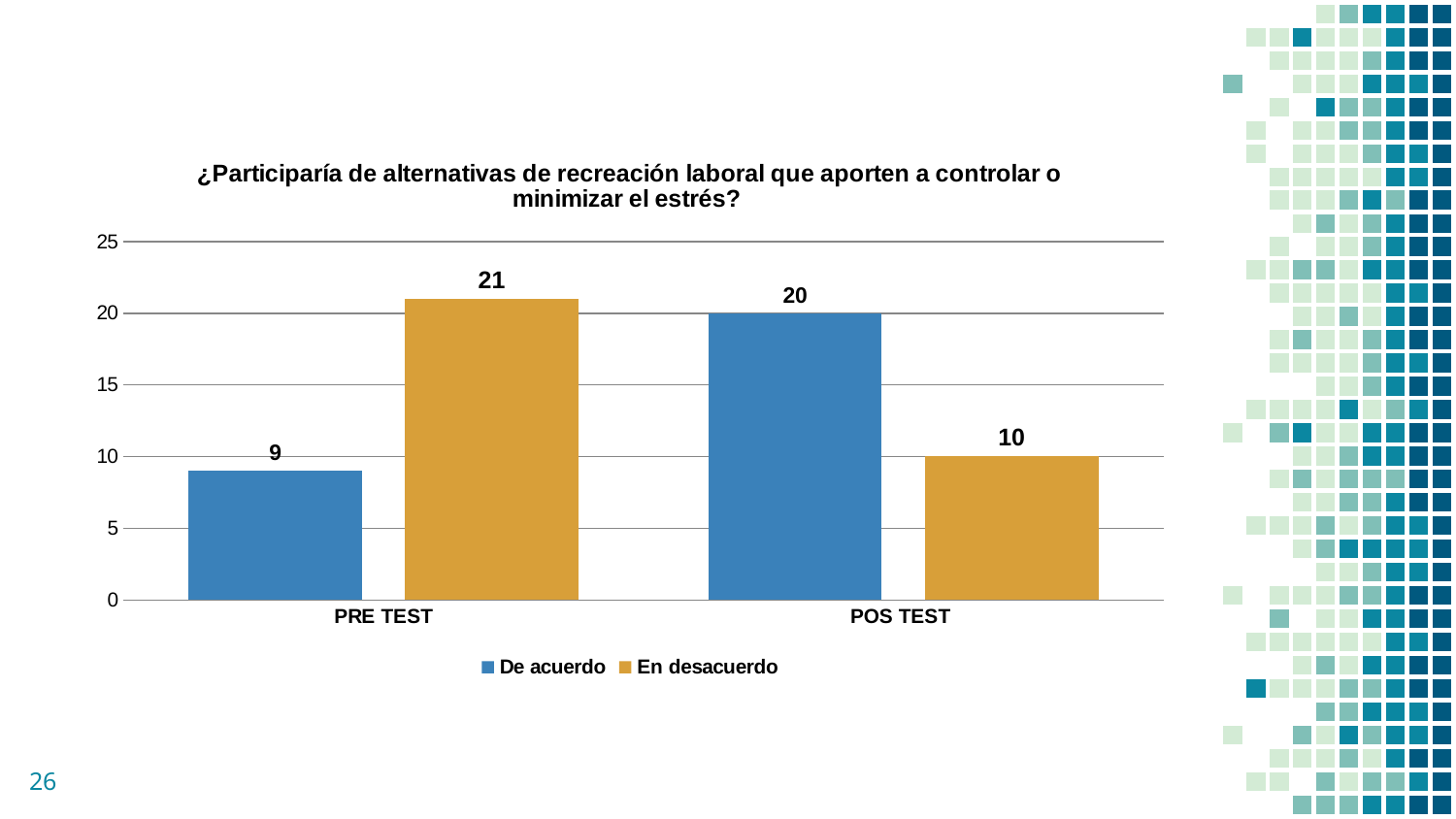
How many series does the legend list? 2 Which bar has the highest value in the chart? En desacuerdo, PRE TEST Which bar has the lowest value in the chart? De acuerdo, PRE TEST Which is larger in POS TEST, De acuerdo or En desacuerdo? De acuerdo What is the value for De acuerdo in POS TEST? 20 What kind of chart is shown on the slide? Bar chart What is the value for En desacuerdo in PRE TEST? 21 What is the value for En desacuerdo in POS TEST? 10 What colour are the En desacuerdo bars? Orange What is the difference between En desacuerdo and De acuerdo in PRE TEST? 12 What is the value for De acuerdo in PRE TEST? 9 What is the difference between De acuerdo in POS TEST and De acuerdo in PRE TEST? 11